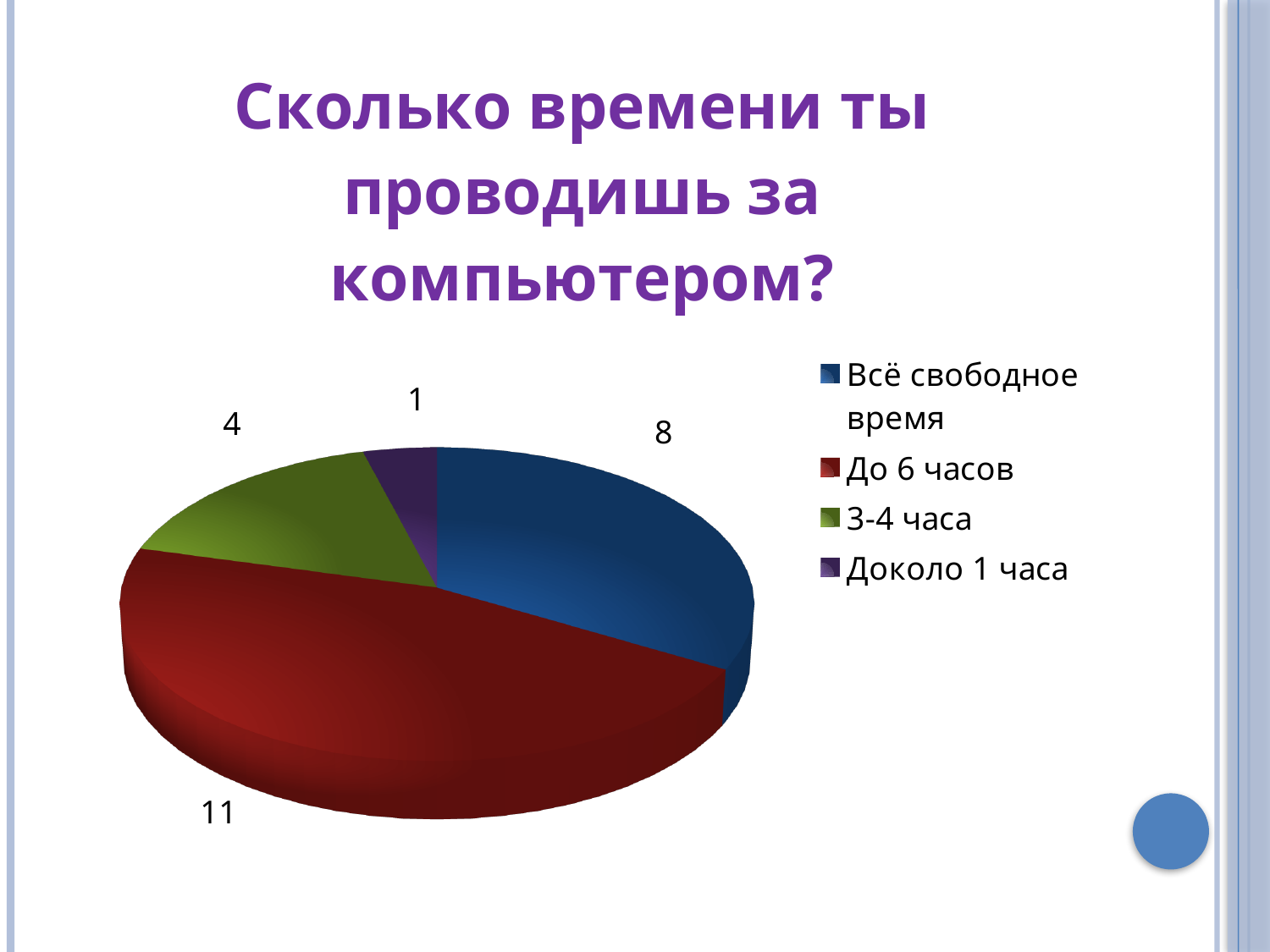
What is the total of all the slice values in the pie chart? 24 Which category has the largest slice? До 6 часов What is the value for "3-4 часа"? 4 Which category has the smallest slice? Доколо 1 часа What is the value for "Доколо 1 часа"? 1 What is the value for "До 6 часов"? 11 How many categories does the pie chart have? 4 What is the title of the slide above the chart? Сколько времени ты проводишь за компьютером? What kind of chart is shown on the slide? pie chart What is the value for "Всё свободное время"? 8 Which is larger, the value for "3-4 часа" or the value for "Всё свободное время"? Всё свободное время What is the difference between the values for "До 6 часов" and "Всё свободное время"? 3